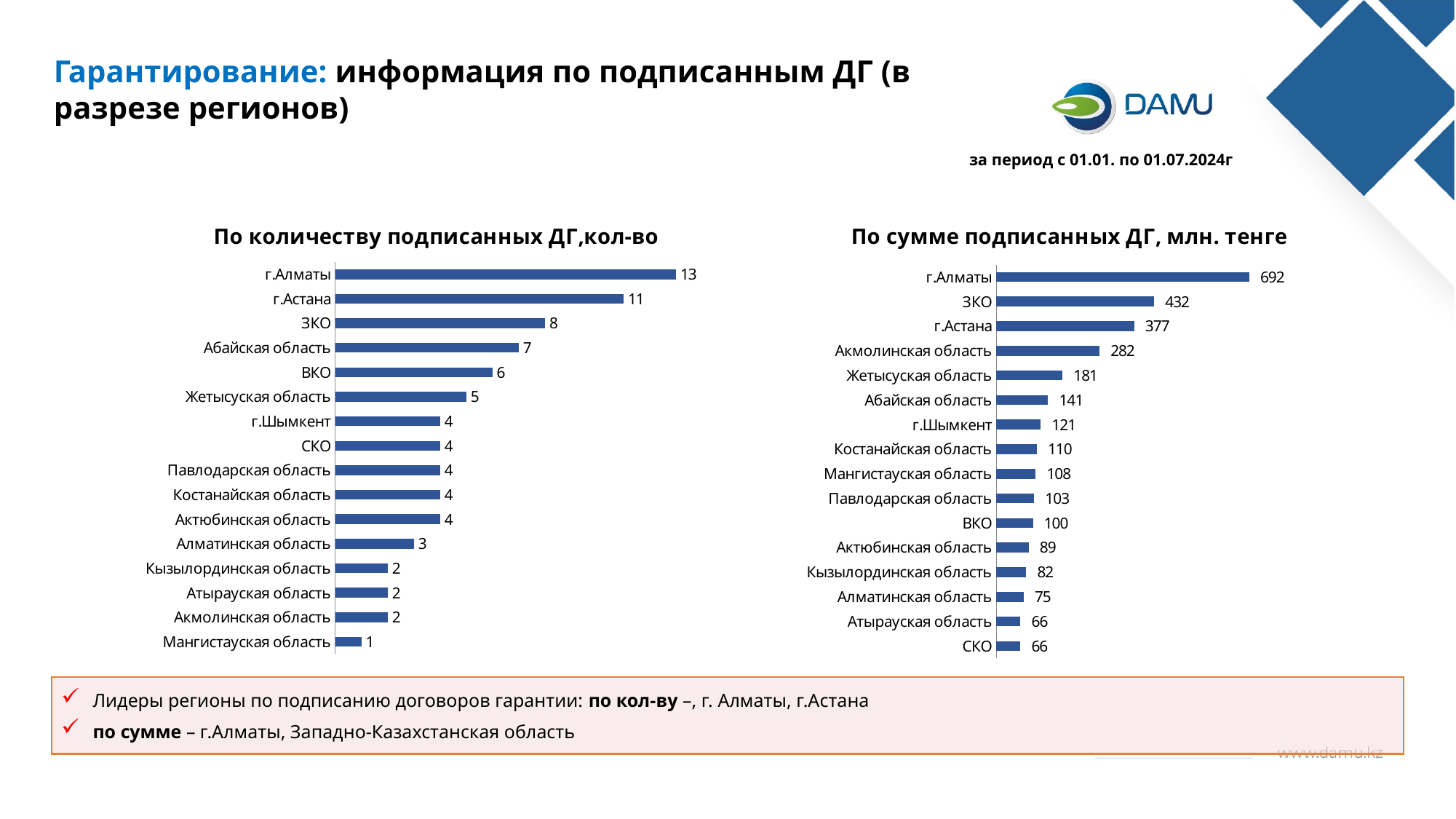
What type of chart is 'По количеству подписанных ДГ,кол-во'? Bar chart In the chart 'По сумме подписанных ДГ, млн. тенге', what is the value for Акмолинская область? 282 In the chart 'По сумме подписанных ДГ, млн. тенге', which region has the highest value? г.Алматы In the chart 'По сумме подписанных ДГ, млн. тенге', what is the difference between г.Алматы and ЗКО? 260 In the chart 'По количеству подписанных ДГ,кол-во', which region has the lowest value? Мангистауская область How many regions are shown in the chart 'По сумме подписанных ДГ, млн. тенге'? 16 In the chart 'По количеству подписанных ДГ,кол-во', which region has the highest value? г.Алматы In the chart 'По сумме подписанных ДГ, млн. тенге', which is larger: Жетысуская область or Абайская область? Жетысуская область In the chart 'По сумме подписанных ДГ, млн. тенге', what is the value for ВКО? 100 In the chart 'По количеству подписанных ДГ,кол-во', which is larger: ВКО or Алматинская область? ВКО In the chart 'По количеству подписанных ДГ,кол-во', what is the value for г.Астана? 11 In the chart 'По количеству подписанных ДГ,кол-во', what is the difference between г.Алматы and ЗКО? 5